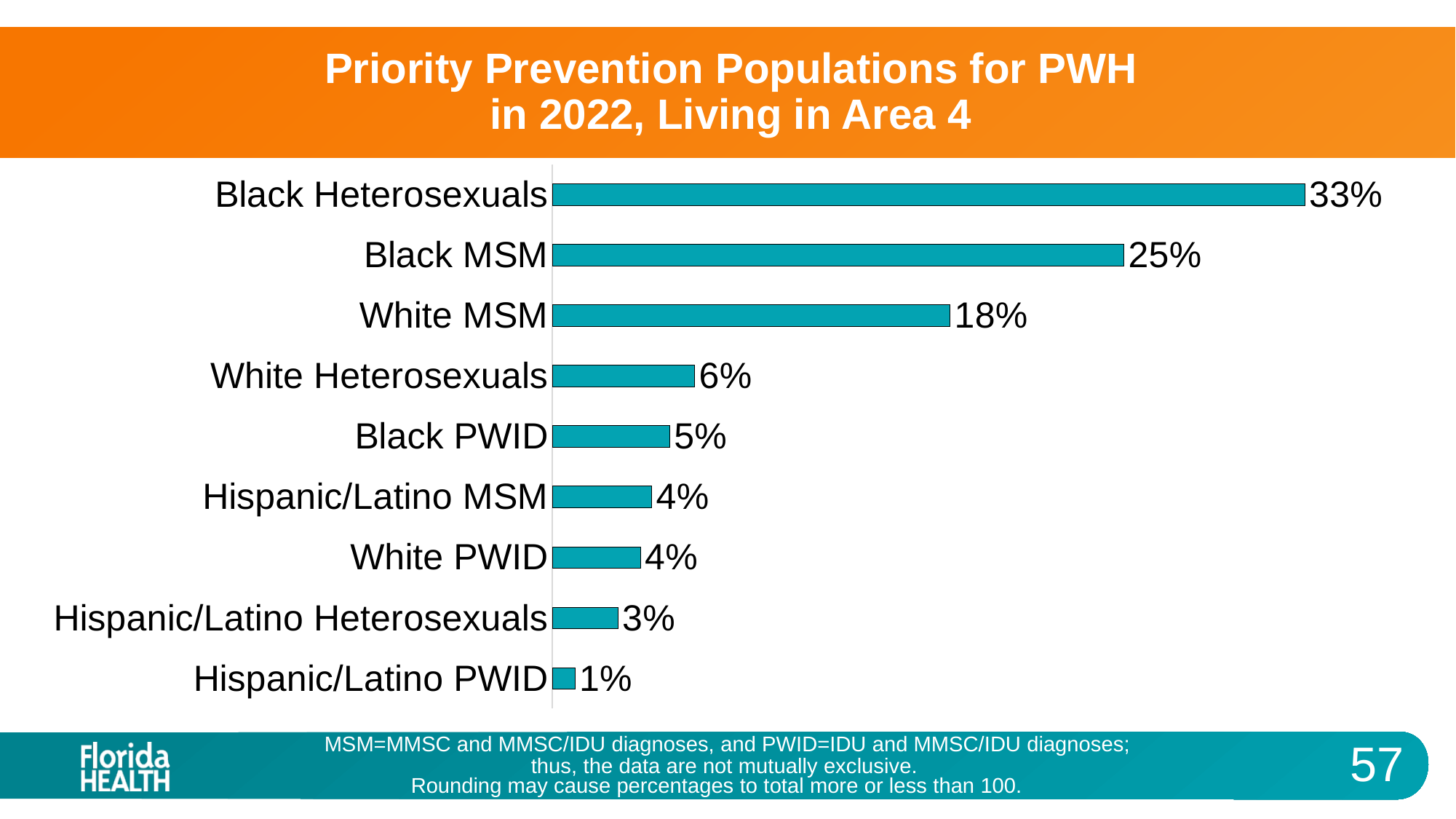
What percentage is shown for Black Heterosexuals? 33% What is the title of the chart? Priority Prevention Populations for PWH in 2022, Living in Area 4 What percentage is shown for White MSM? 18% Which is larger, the value for Black MSM or the value for White MSM? Black MSM How many populations are shown in the chart? 9 What is the difference in percentage points between White MSM and White Heterosexuals? 12 What is the difference in percentage points between Black Heterosexuals and Black MSM? 8 Which is larger, the value for Black PWID or the value for White PWID? Black PWID What kind of chart is shown on the slide? Bar chart Which population has the lowest percentage? Hispanic/Latino PWID Which population has the highest percentage? Black Heterosexuals What percentage is shown for Hispanic/Latino Heterosexuals? 3%